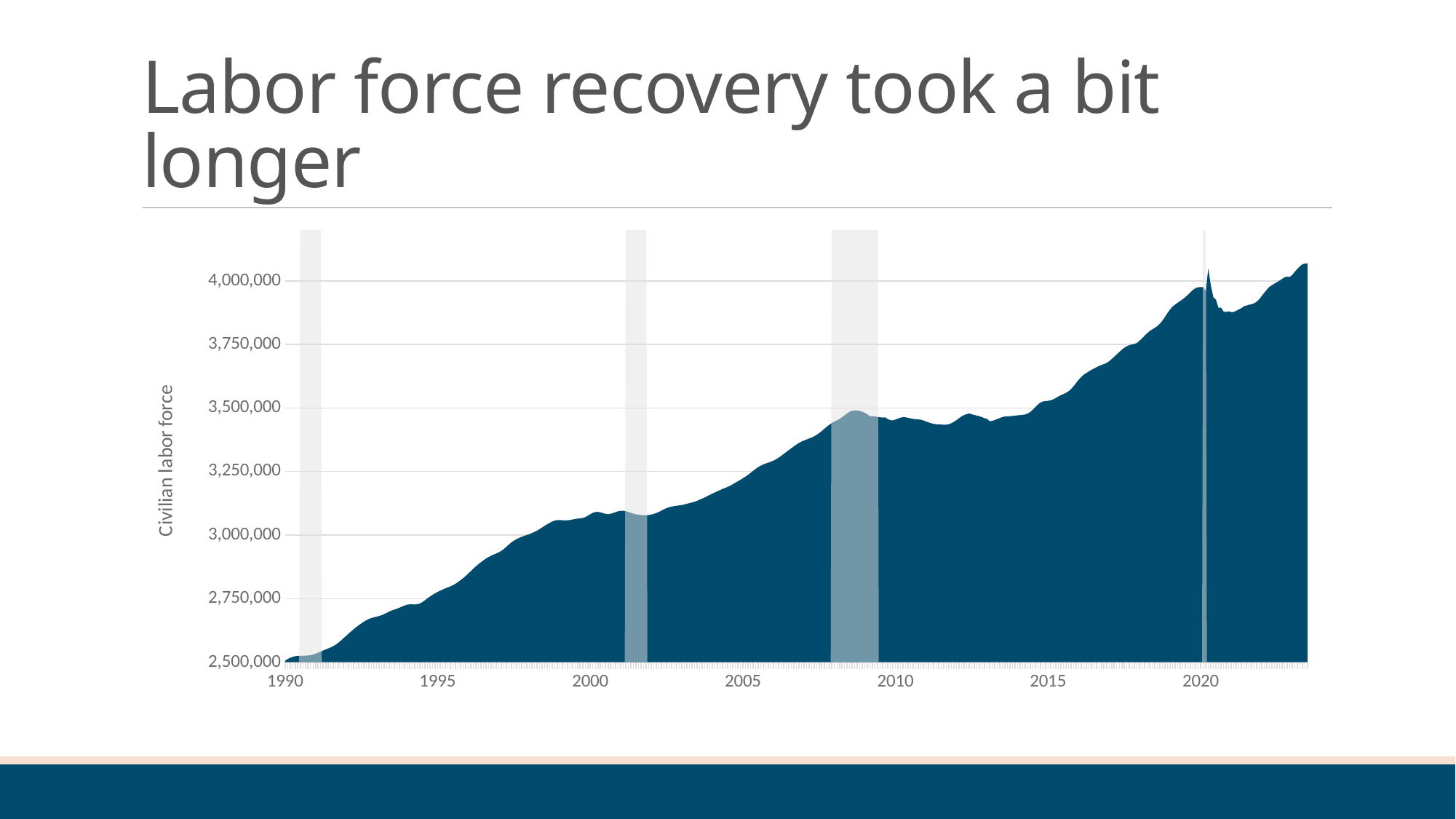
What is the highest value labeled on the vertical axis? 4,000,000 What is the label on the vertical axis of the chart? Civilian labor force Overall, does the civilian labor force rise or fall from 1990 to the end of the series? rise Is the civilian labor force value in 2020 greater or less than 3,750,000? greater How many year labels are shown on the horizontal axis? 7 What kind of chart is shown on the slide? area chart What is the title of the slide containing the chart? Labor force recovery took a bit longer Is the civilian labor force value in 2005 greater or less than 3,000,000? greater Is the civilian labor force value in 1990 greater or less than 2,750,000? less